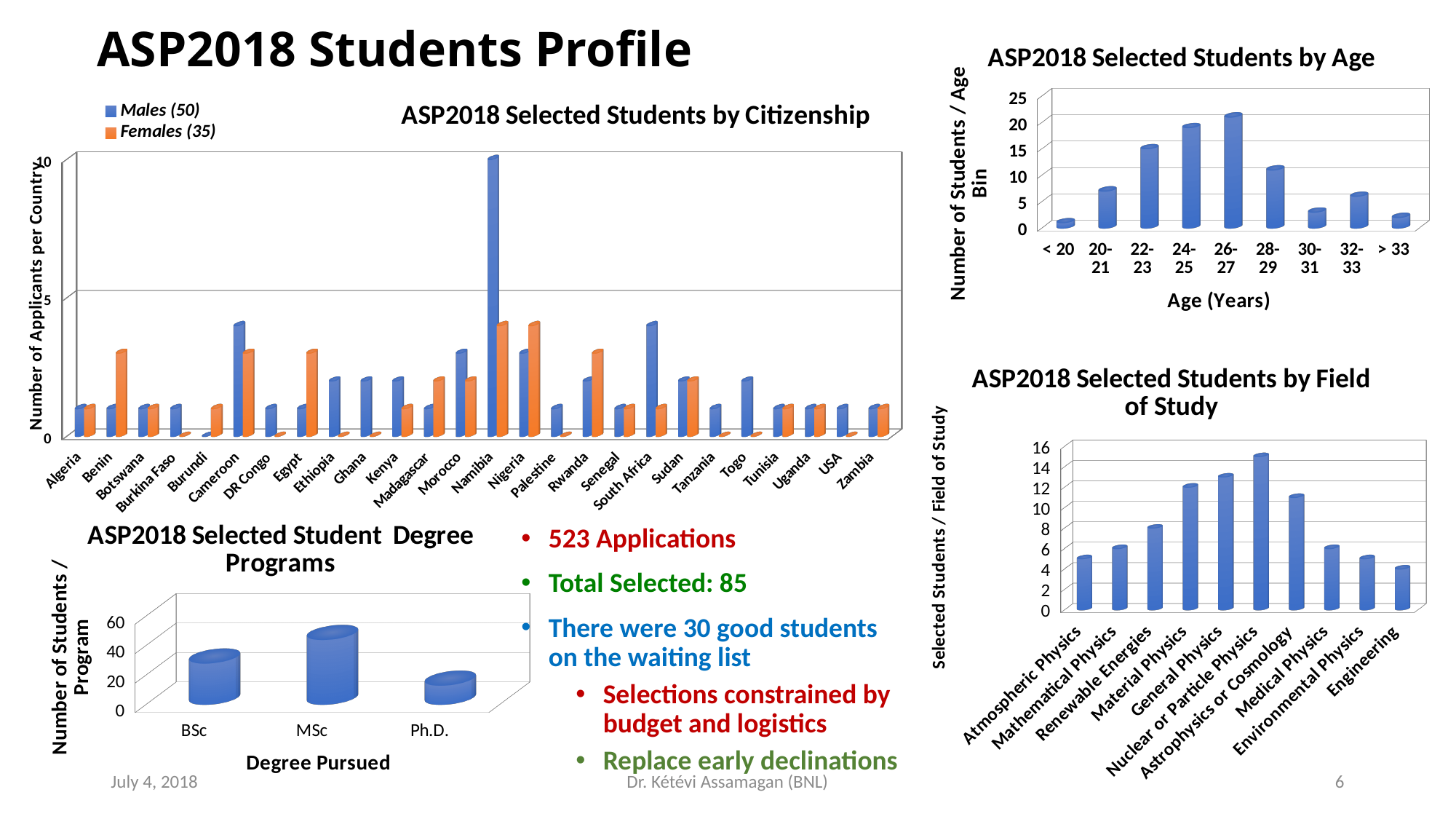
In the ASP2018 Selected Students by Age chart, is the value for 24-25 greater or less than 15? greater In the ASP2018 Selected Student Degree Programs chart, which degree has the highest number of students? MSc In the ASP2018 Selected Students by Field of Study chart, which field has the most selected students? Nuclear or Particle Physics How many countries are shown on the x axis of the ASP2018 Selected Students by Citizenship chart? 26 In the ASP2018 Selected Students by Field of Study chart, is the value for Material Physics greater or less than 10? greater How many series does the legend of the ASP2018 Selected Students by Citizenship chart list? 2 In the ASP2018 Selected Students by Citizenship chart, what are the two legend entries? Males (50) and Females (35) What kind of chart is the ASP2018 Selected Students by Field of Study chart? bar chart How many age bins are shown in the ASP2018 Selected Students by Age chart? 9 In the ASP2018 Selected Students by Age chart, which age bin has the most students? 26-27 In the ASP2018 Selected Students by Age chart, which age bin has the fewest students? < 20